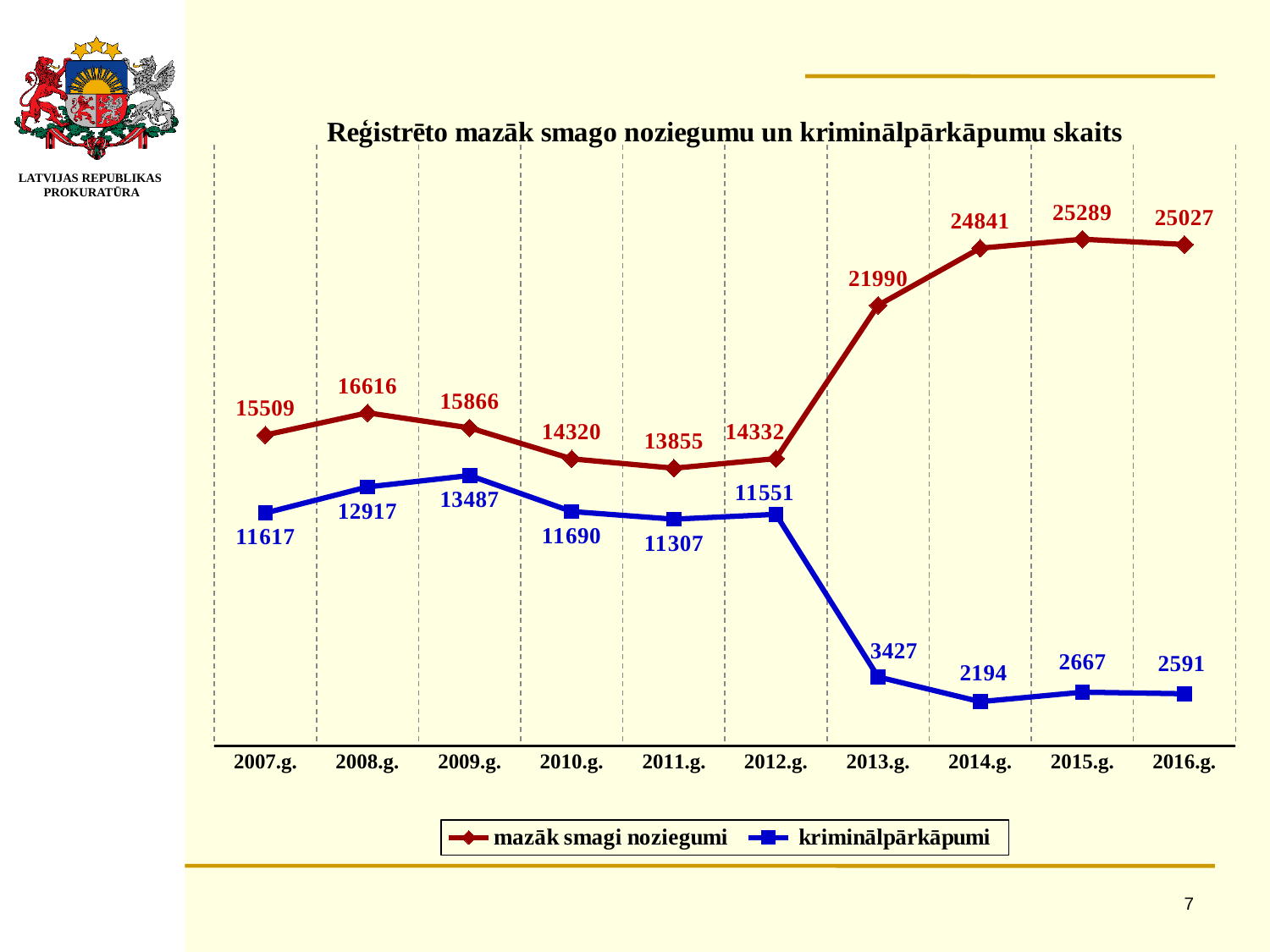
What kind of chart is shown on the slide? line chart What is the value for kriminālpārkāpumi in 2009.g.? 13487 What is the difference between mazāk smagi noziegumi and kriminālpārkāpumi in 2013.g.? 18563 What is the value for kriminālpārkāpumi in 2014.g.? 2194 In which year is the value for kriminālpārkāpumi lowest? 2014.g. What is the title of the chart? Reģistrēto mazāk smago noziegumu un kriminālpārkāpumu skaits What is the value for mazāk smagi noziegumi in 2015.g.? 25289 In which year is the value for mazāk smagi noziegumi highest? 2015.g. Which is larger: kriminālpārkāpumi in 2008.g. or in 2012.g.? 2008.g. Does the value for kriminālpārkāpumi rise or fall from 2012.g. to 2013.g.? fall How many series does the legend list? 2 How many years are shown on the x axis? 10